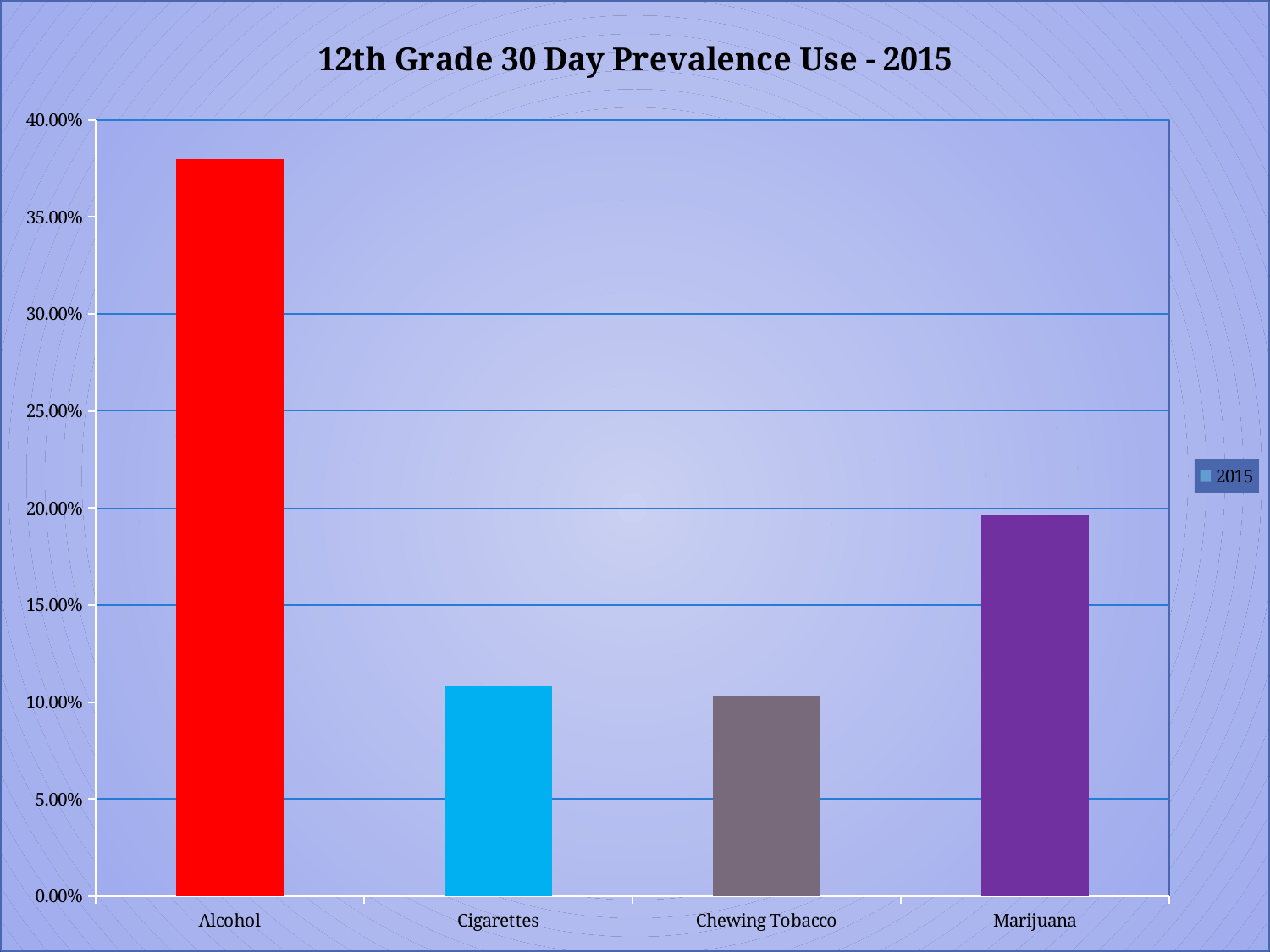
Is the value for Chewing Tobacco greater or less than 15.00%? less What kind of chart is shown on the slide? bar chart How many series does the legend list? 1 Which is larger, the value for Alcohol or the value for Marijuana? Alcohol Is the value for Alcohol greater or less than 35.00%? greater What is the title of the chart? 12th Grade 30 Day Prevalence Use - 2015 Which category has the highest value? Alcohol How many categories are shown on the x axis? 4 What colour is the bar for Alcohol? red Is the value for Cigarettes greater or less than 10.00%? greater Which is larger, the value for Marijuana or the value for Cigarettes? Marijuana